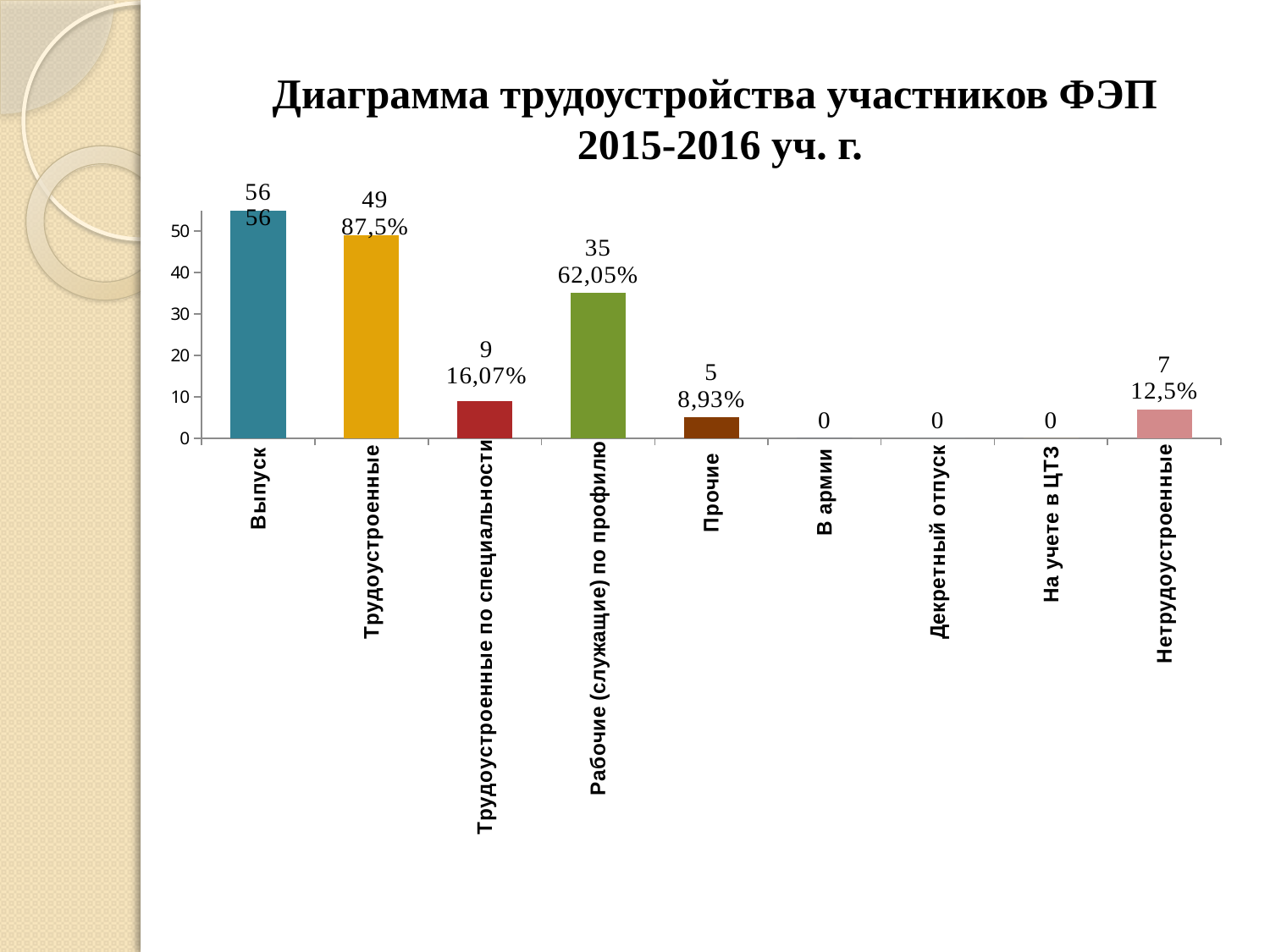
Which category has the highest value? Выпуск What percentage is shown above the bar for Рабочие (служащие) по профилю? 62,05% How many categories have a value of 0? 3 What is the value for Выпуск? 56 What percentage is shown for Трудоустроенные по специальности? 16,07% Which is larger, the value for Прочие or the value for Нетрудоустроенные? Нетрудоустроенные What is the difference between the values for Выпуск and Трудоустроенные? 7 How many categories are shown on the x axis? 9 What is the value for Нетрудоустроенные? 7 What is the title of the chart? Диаграмма трудоустройства участников ФЭП 2015-2016 уч. г. What is the value for Трудоустроенные? 49 What kind of chart is shown on the slide? bar chart